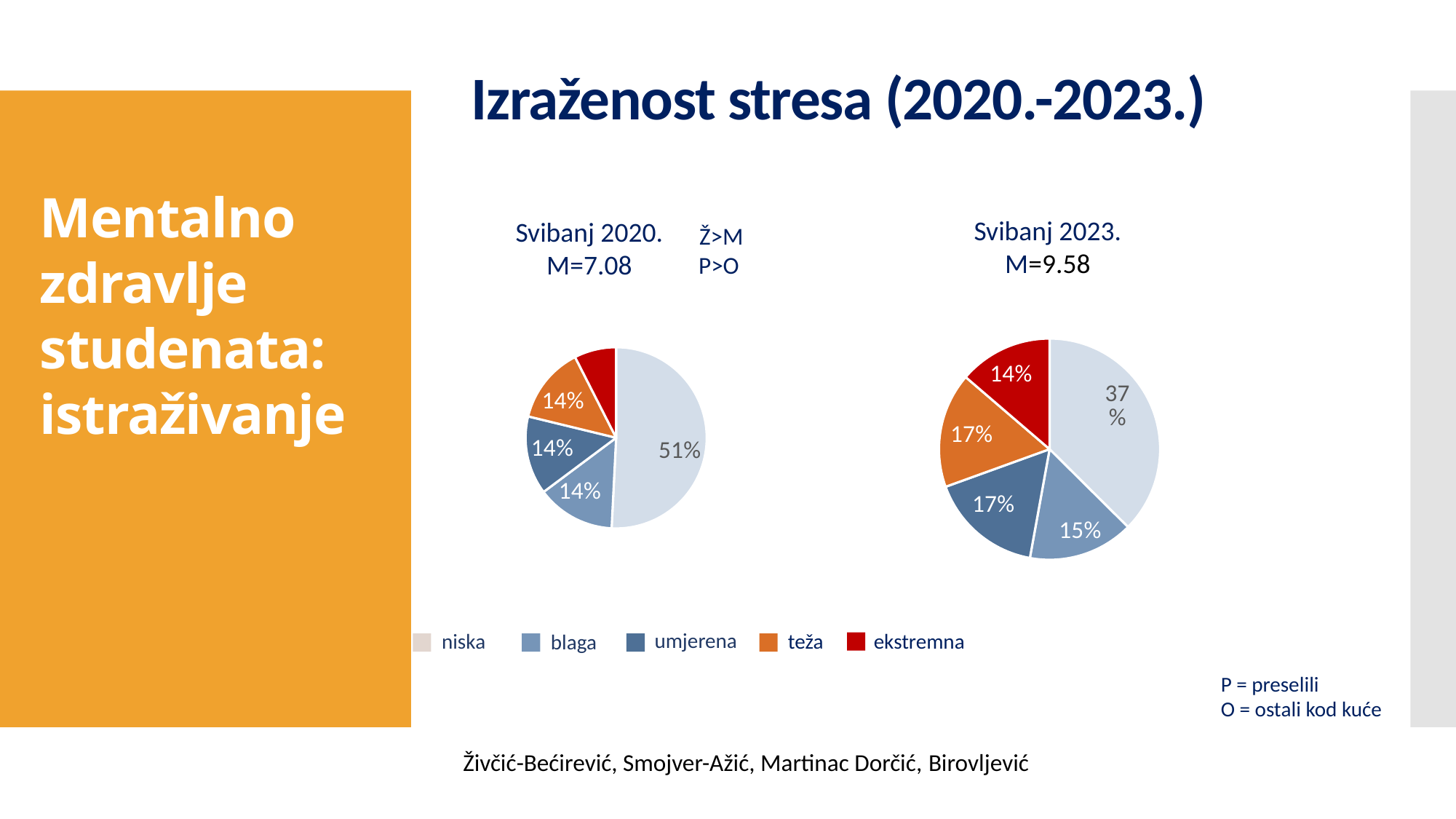
In the Svibanj 2020. pie chart, what share is labelled for the niska slice? 51% Is the niska share larger in the Svibanj 2020. pie chart or in the Svibanj 2023. pie chart? Svibanj 2020. In the Svibanj 2023. pie chart, what share is labelled for the blaga slice? 15% In the Svibanj 2023. pie chart, what share is labelled for the niska slice? 37% In the Svibanj 2023. pie chart, what share is labelled for the ekstremna slice? 14% What is the mean value (M) shown above the Svibanj 2023. pie chart? M=9.58 In the Svibanj 2020. pie chart, which category has the smallest slice? ekstremna What type of chart is used to show the stress levels for Svibanj 2020. and Svibanj 2023.? pie chart How many categories does the legend list for the pie charts? 5 In the Svibanj 2023. pie chart, which category has the largest slice? niska In the Svibanj 2020. pie chart, what share is labelled for the teža slice? 14% What is the difference between the niska share in the Svibanj 2020. pie chart (51%) and in the Svibanj 2023. pie chart (37%)? 14%